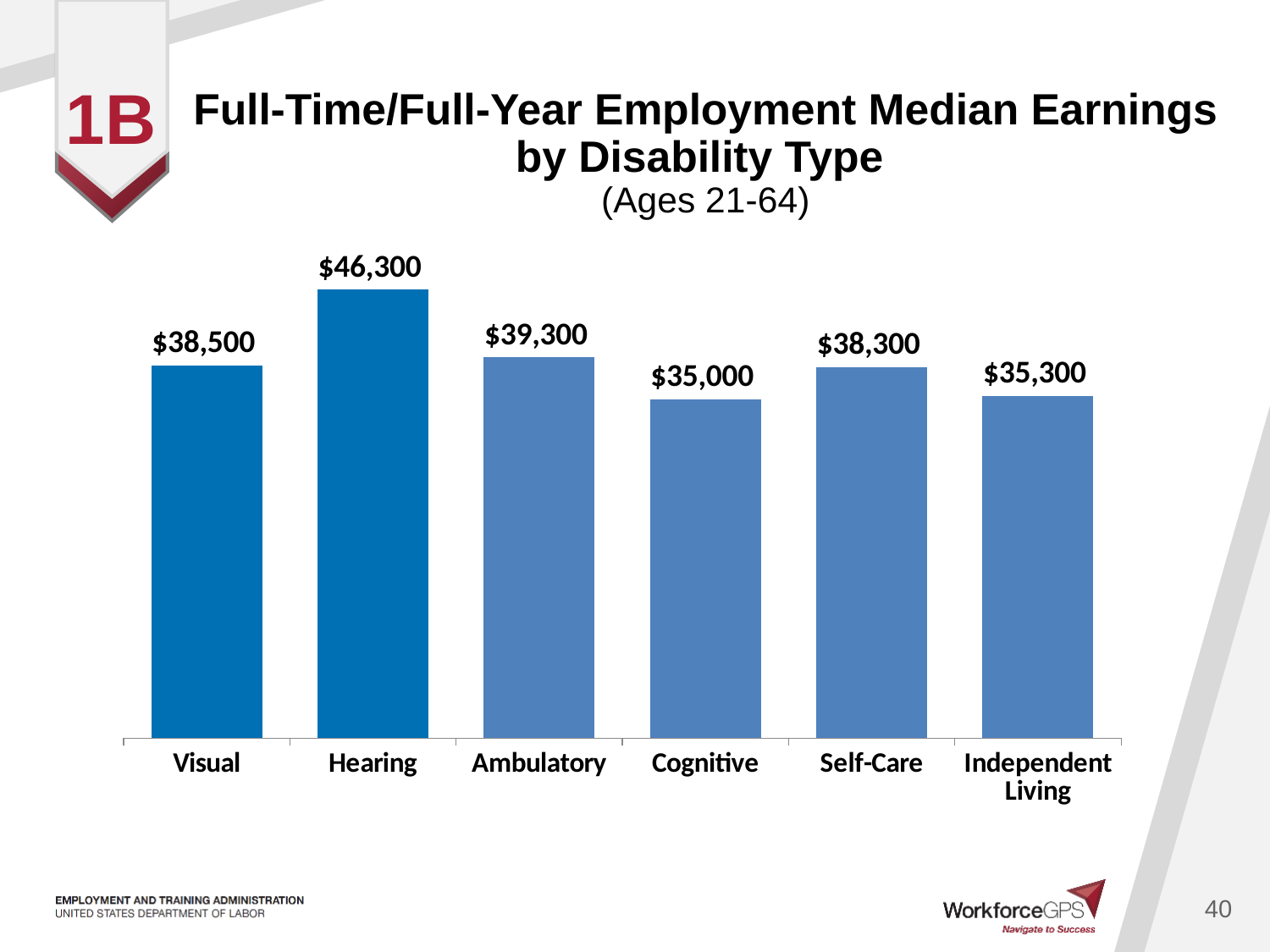
Which has higher median earnings, Visual or Ambulatory? Ambulatory What is the difference between the median earnings for Hearing and Visual? $7,800 What is the difference between the median earnings for Ambulatory and Cognitive? $4,300 What is the median earnings value for Cognitive? $35,000 What is the median earnings value for Self-Care? $38,300 Which disability type has the lowest median earnings? Cognitive How many disability types are shown in the chart? 6 What kind of chart is shown on the slide? Bar chart What is the median earnings value for Hearing? $46,300 What is the median earnings value for Independent Living? $35,300 Which disability type has the highest median earnings? Hearing What age range does the chart title say the data covers? Ages 21-64